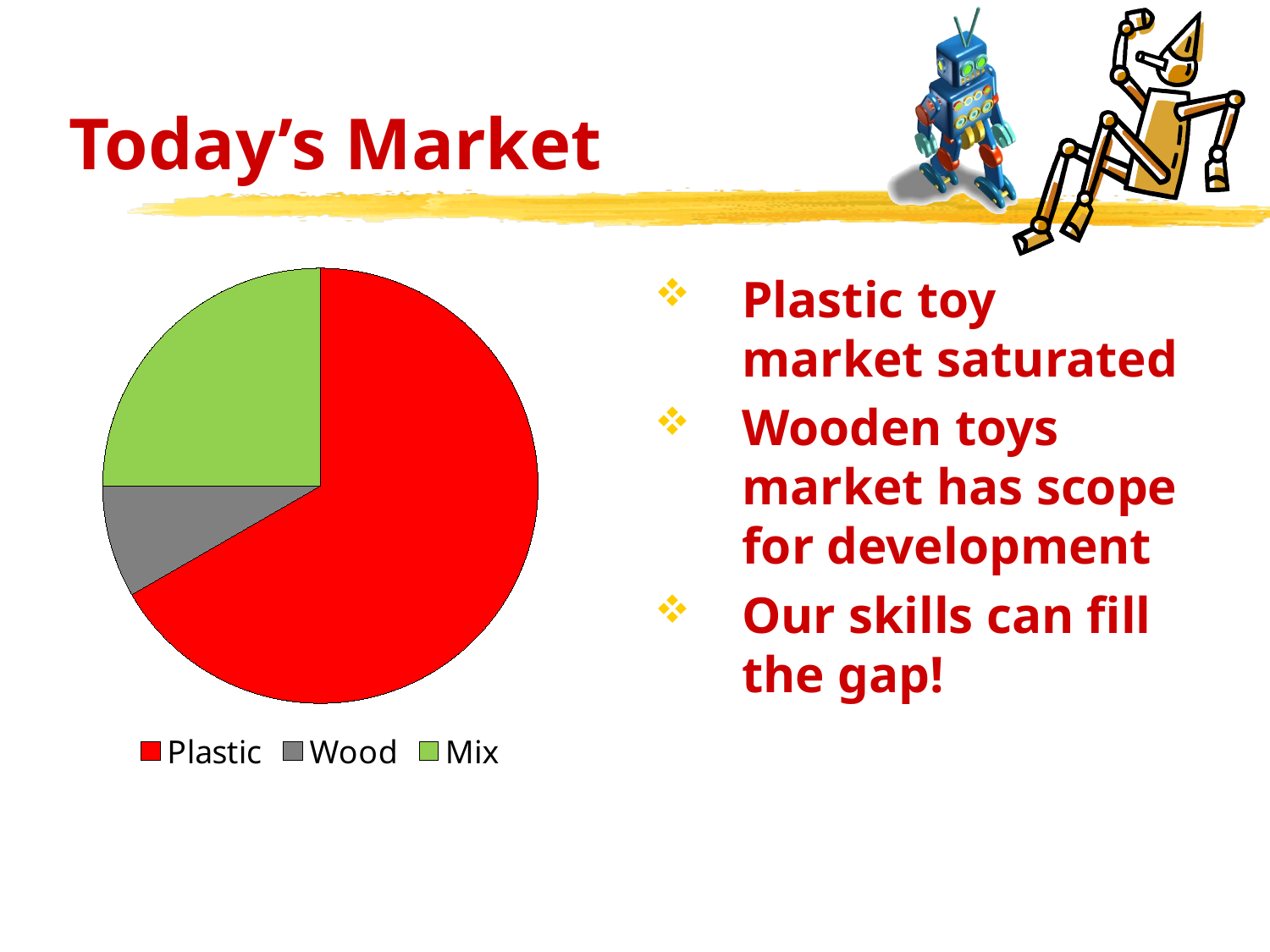
How many slices does the pie chart have? 3 Which slice is larger, Wood or Mix? Mix What kind of chart is shown on the slide? pie chart What colour is the Plastic slice in the pie chart? red Which slice is larger, Plastic or Mix? Plastic Does the Plastic slice take up more or less than half of the pie? more Which category is shown in green in the pie chart? Mix Which category has the smallest slice of the pie chart? Wood How many entries does the legend list? 3 Which category has the largest slice of the pie chart? Plastic